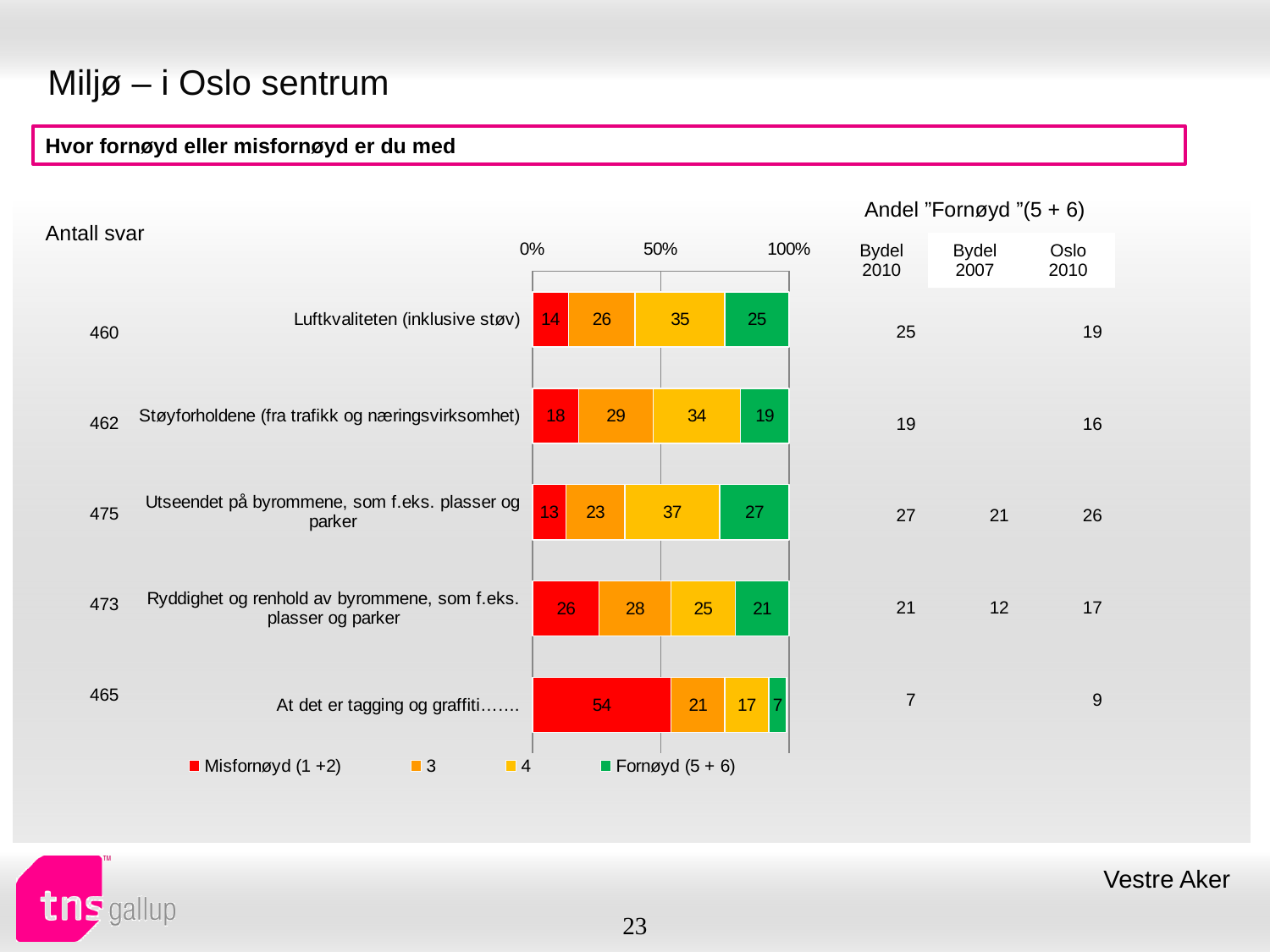
What is the value of the "Fornøyd (5 + 6)" segment for "Luftkvaliteten (inklusive støv)"? 25 How many series does the legend list? 4 What is the difference between the "Misfornøyd (1 +2)" values for "Ryddighet og renhold av byrommene, som f.eks. plasser og parker" and "Luftkvaliteten (inklusive støv)"? 12 What is the value of the "4" segment for "Utseendet på byrommene, som f.eks. plasser og parker"? 37 What is the value of the "3" segment for "Støyforholdene (fra trafikk og næringsvirksomhet)"? 29 What kind of chart is shown on the slide? Stacked bar chart Which category has the lowest "Fornøyd (5 + 6)" value? At det er tagging og graffiti……. What is the total of the stacked bar for "Ryddighet og renhold av byrommene, som f.eks. plasser og parker"? 100 How many categories are shown in the chart? 5 Which is larger: the "Fornøyd (5 + 6)" value for "Utseendet på byrommene, som f.eks. plasser og parker" or for "Støyforholdene (fra trafikk og næringsvirksomhet)"? Utseendet på byrommene, som f.eks. plasser og parker What is the value of the "Misfornøyd (1 +2)" segment for "At det er tagging og graffiti……."? 54 Which category has the highest "Misfornøyd (1 +2)" value? At det er tagging og graffiti…….